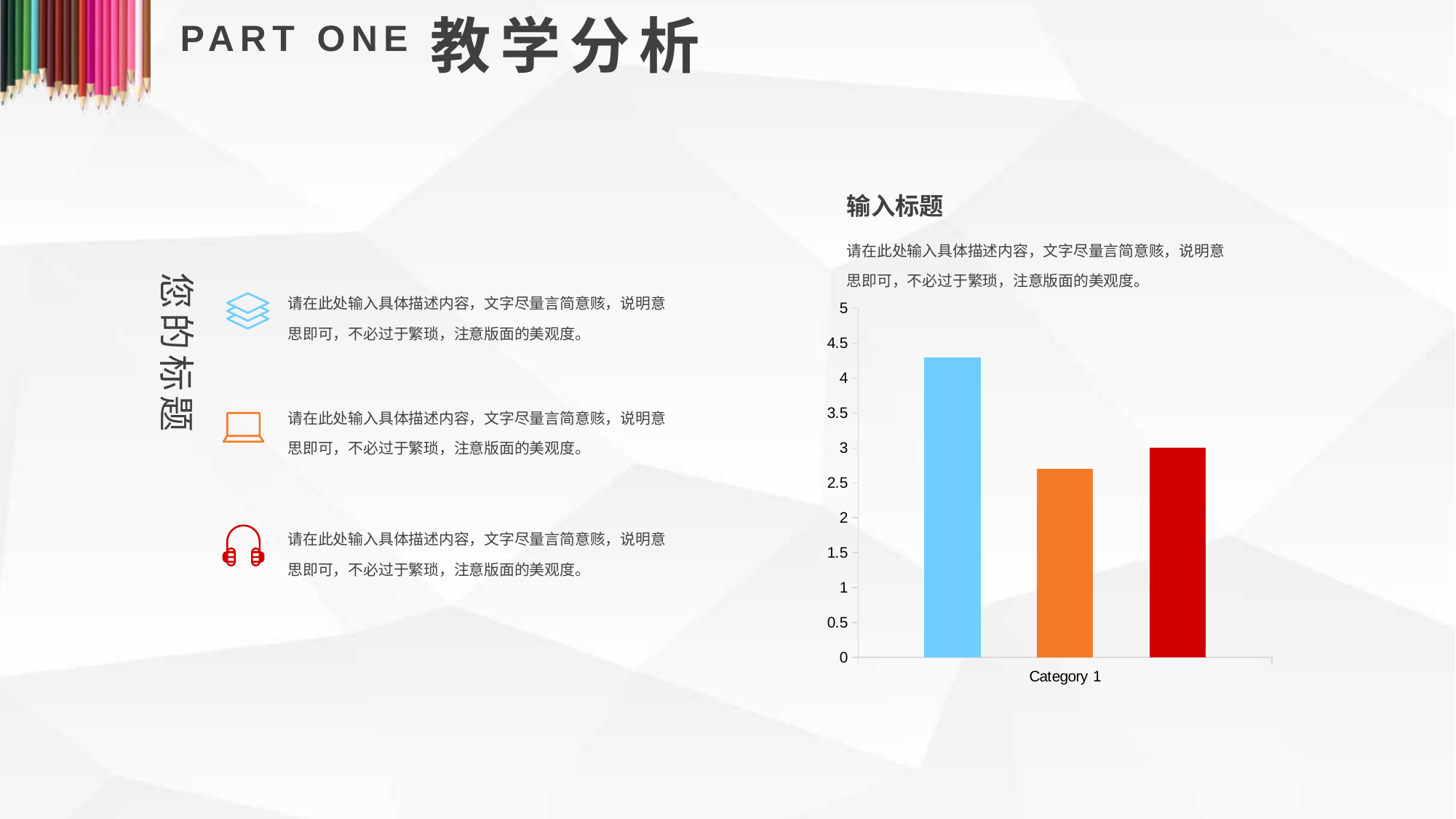
How many bars are plotted in the chart? 3 Which bar is the shortest in the chart? the orange bar What is the label of the category on the x axis? Category 1 What is the value of the red bar? 3 Is the value of the blue bar greater or less than 4.5? less Which is larger, the red bar or the orange bar? the red bar Is the value of the blue bar greater or less than 4? greater Which bar is the tallest in the chart? the blue bar How many categories are shown on the x axis of the chart? 1 What kind of chart is shown on the slide? bar chart What is the maximum value shown on the y axis of the chart? 5 Is the value of the orange bar greater or less than 3? less